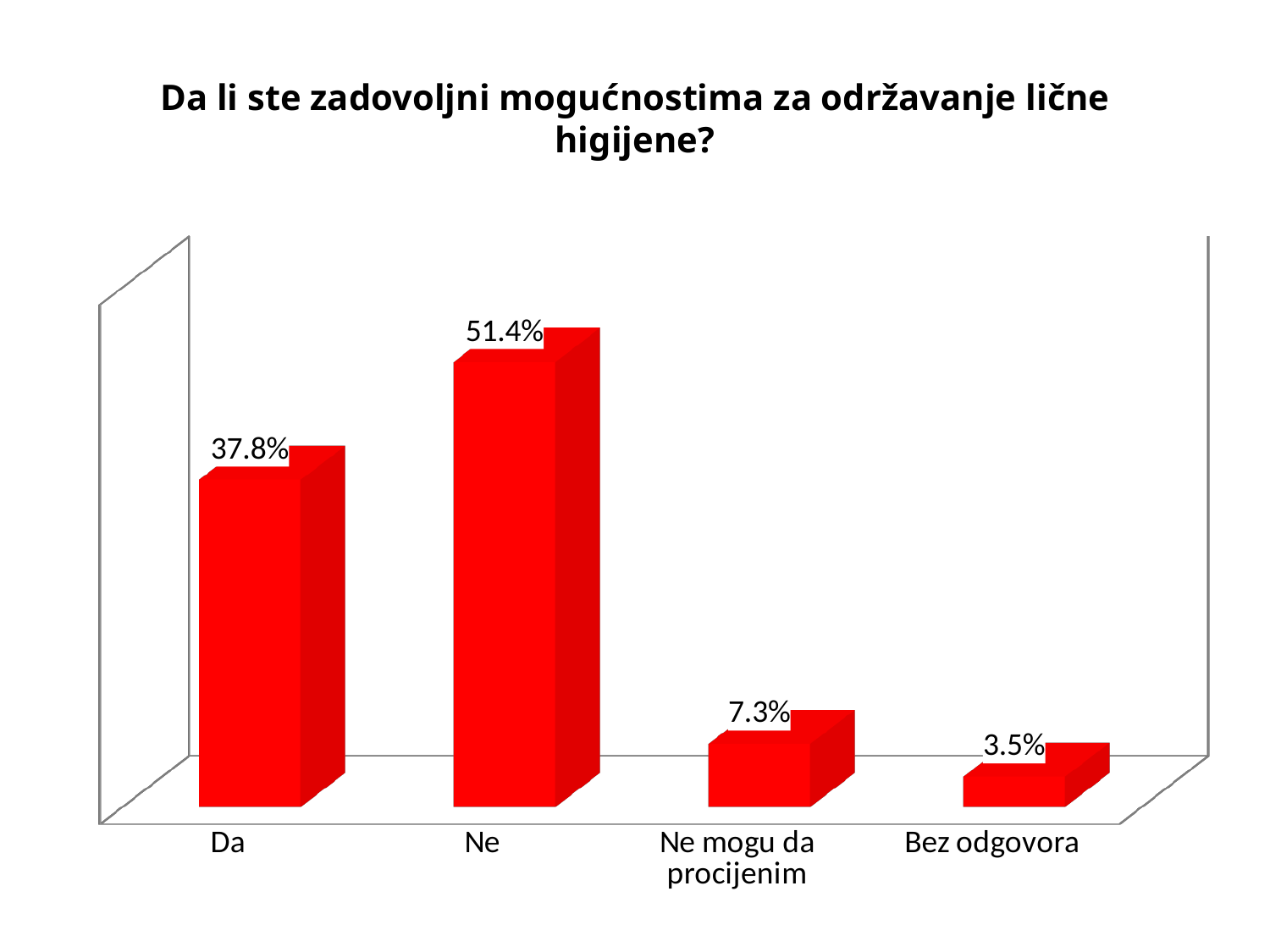
What is the difference between the values for "Ne" and "Da"? 13.6% What kind of chart is shown on the slide? Bar chart Which category has the lowest value? Bez odgovora What is the title of the chart? Da li ste zadovoljni mogućnostima za održavanje lične higijene? What is the value for "Ne mogu da procijenim"? 7.3% What is the value for "Ne"? 51.4% What is the value for "Bez odgovora"? 3.5% What is the difference between the values for "Ne mogu da procijenim" and "Bez odgovora"? 3.8% Which is larger, the value for "Da" or the value for "Ne mogu da procijenim"? Da How many categories are shown on the chart? 4 Which category has the highest value? Ne What is the value for "Da"? 37.8%